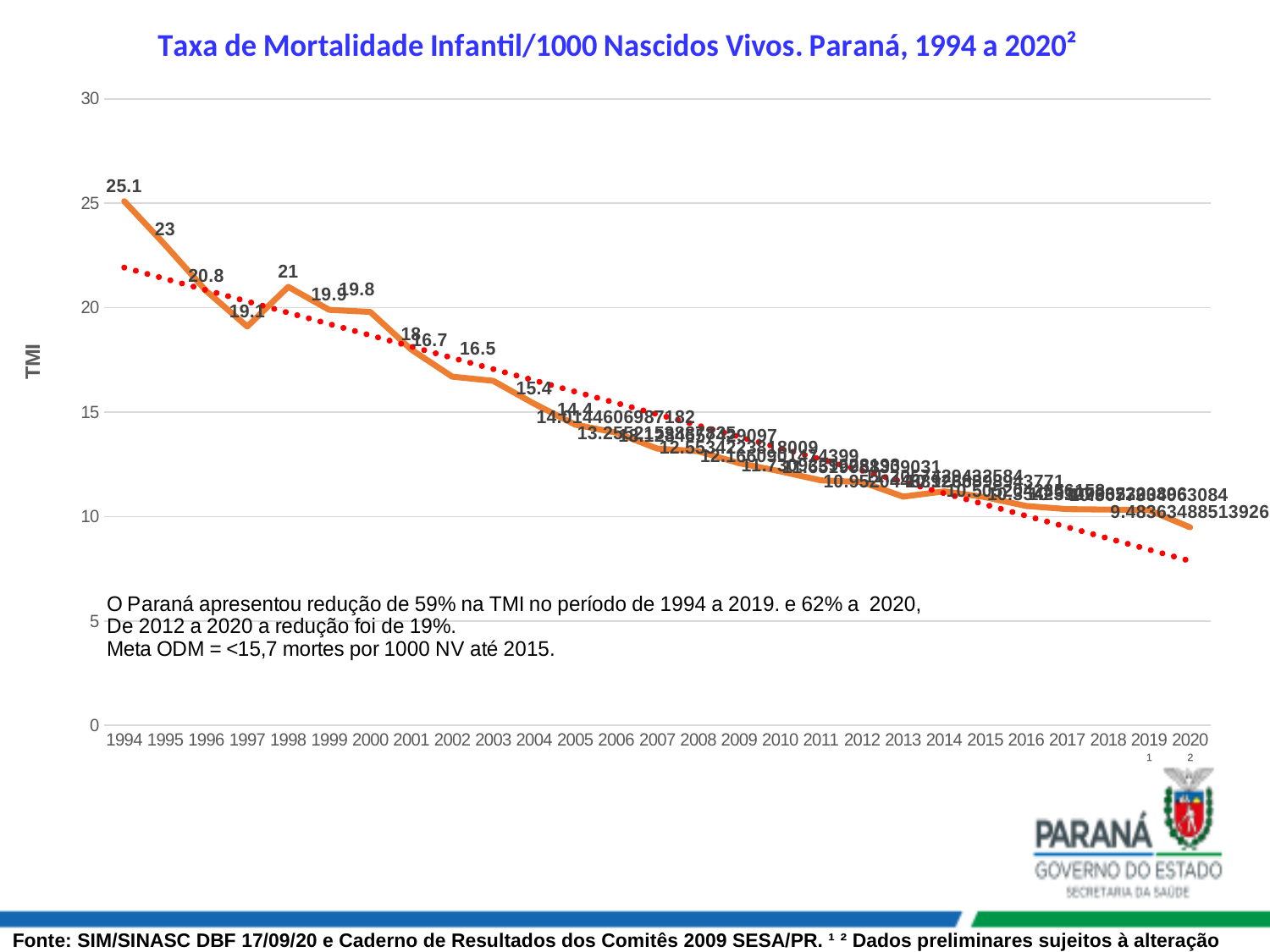
What is the TMI value for 2004? 15.4 What is the TMI value for 1998? 21 How many years are shown on the x axis? 27 Which year has the larger TMI value, 1997 or 1998? 1998 Which year has the highest TMI value? 1994 Is the TMI value for 2013 greater or less than 15? less Which year has the lowest TMI value? 2020 What is the difference between the TMI values for 1994 and 1995? 2.1 Do the TMI values generally rise or fall from 1994 to 2020? fall What kind of chart is shown on the slide? line chart What is the TMI value for 1995? 23 What is the TMI value for 1994? 25.1